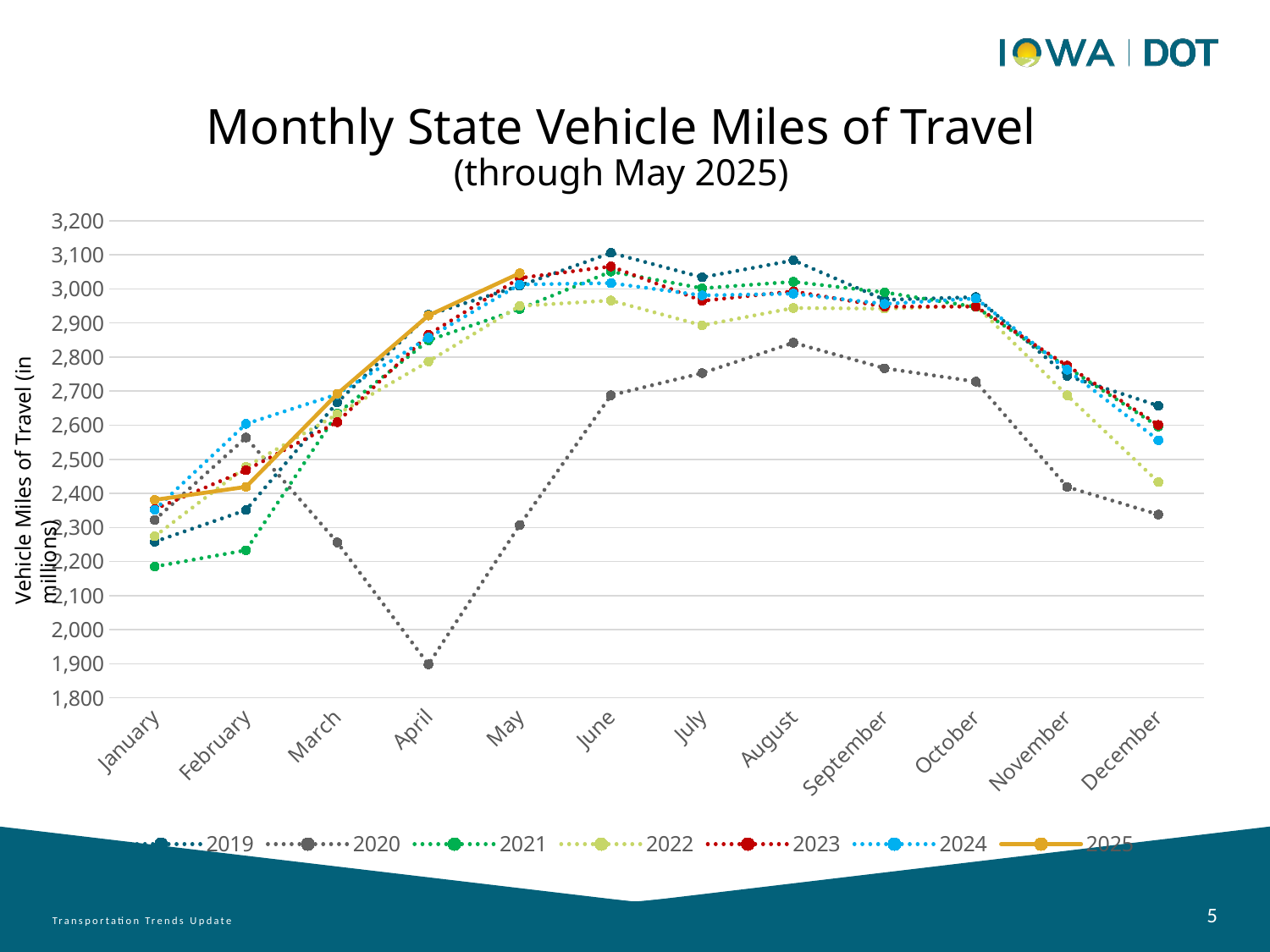
What is the title of the chart? Monthly State Vehicle Miles of Travel (through May 2025) How many months are shown along the x axis? 12 In which month does the 2020 series reach its lowest value? April Is the value for 2025 in May greater or less than 3,000? greater What is the label on the vertical axis? Vehicle Miles of Travel (in millions) Is the value for 2020 in April greater or less than 2,000? less Which series has the lowest value in December? 2020 Is the value for 2019 in June greater or less than 3,000? greater What kind of chart is shown on the slide? line chart Does the 2025 series rise or fall from January to May? rise How many series does the legend list? 7